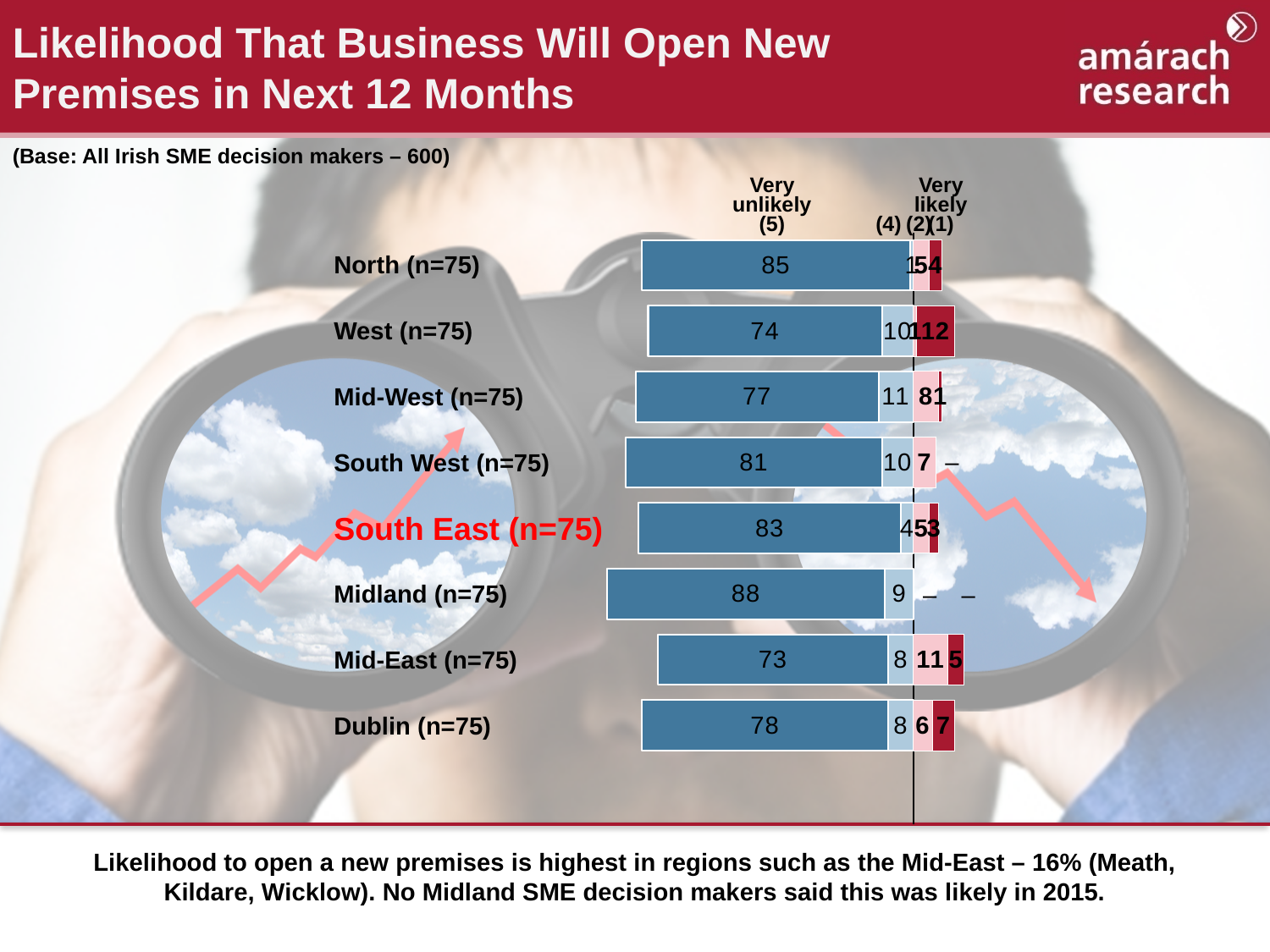
How many regions are shown in the chart? 8 What is the 'Very unlikely (5)' value for Mid-East (n=75)? 73 What is the 'Very likely (1)' value for Dublin (n=75)? 7 Which region's label is highlighted in red on the chart? South East (n=75) What is the difference between the 'Very unlikely (5)' values for Midland and Mid-East? 15 What is the '(4)' value for Mid-West (n=75)? 11 What is the 'Very unlikely (5)' value for Midland (n=75)? 88 What kind of chart is shown on the slide? Stacked bar chart Which region has the highest 'Very unlikely (5)' value? Midland (n=75) Which has a larger 'Very unlikely (5)' value, South East or Dublin? South East What percentage of North SME decision makers said it was very unlikely (5) that their business will open new premises? 85 Which region has the lowest 'Very unlikely (5)' value? Mid-East (n=75)